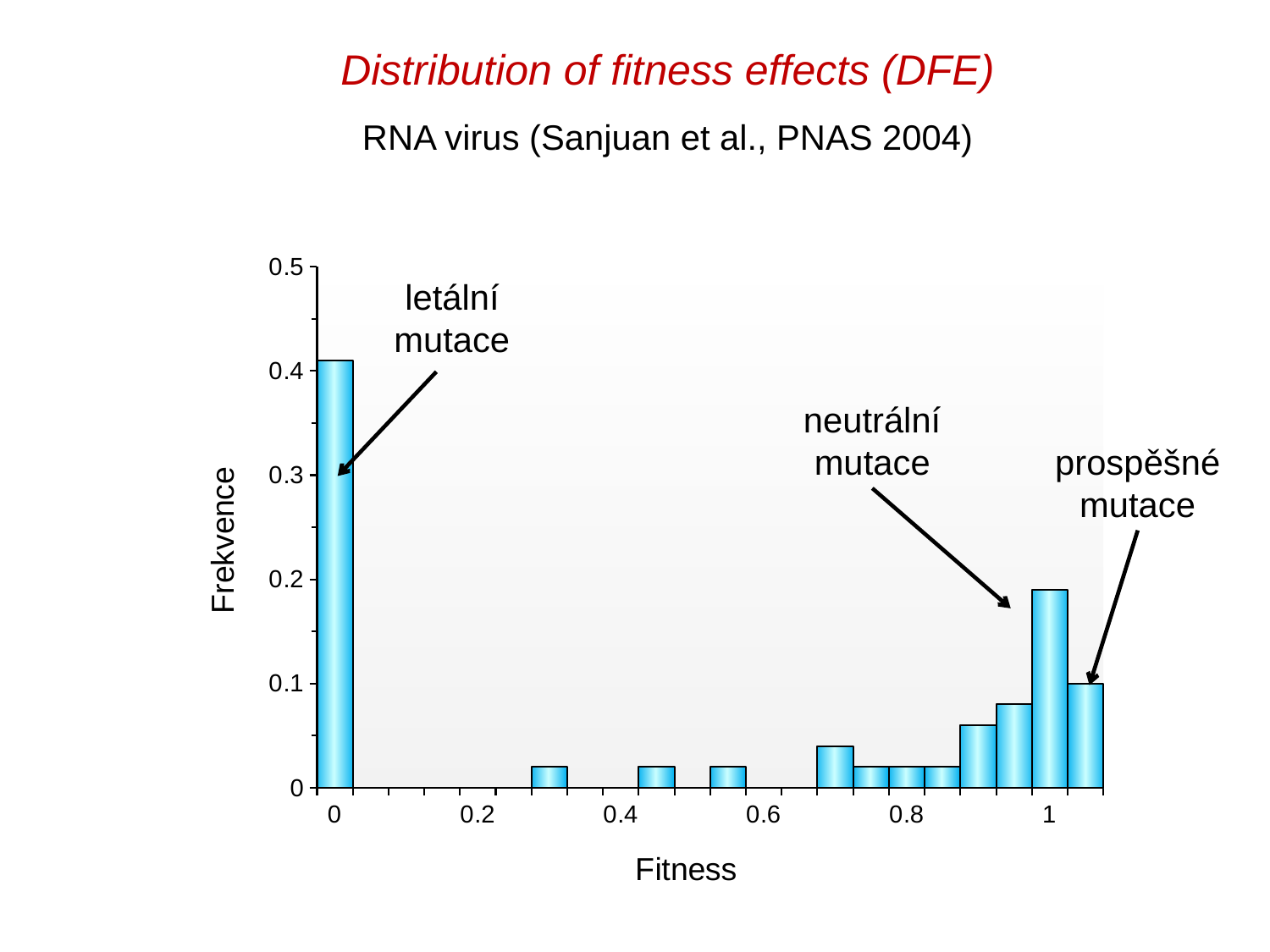
How many bars are plotted in the chart? 12 Is the frequency for fitness 0 greater or less than 0.3? greater Is the frequency for the bar at fitness 0.9 greater or less than 0.1? less What is the label of the x axis? Fitness At which fitness value is the frequency highest? 0 Which annotation points to the bar at fitness 0? letální mutace Is the frequency for the bar at fitness 1 greater or less than 0.2? less Do the bar heights rise or fall as fitness increases from 0.7 to 1? rise What kind of chart is shown on the slide? bar chart Which has the higher frequency, the bar at fitness 0 or the bar at fitness 1? fitness 0